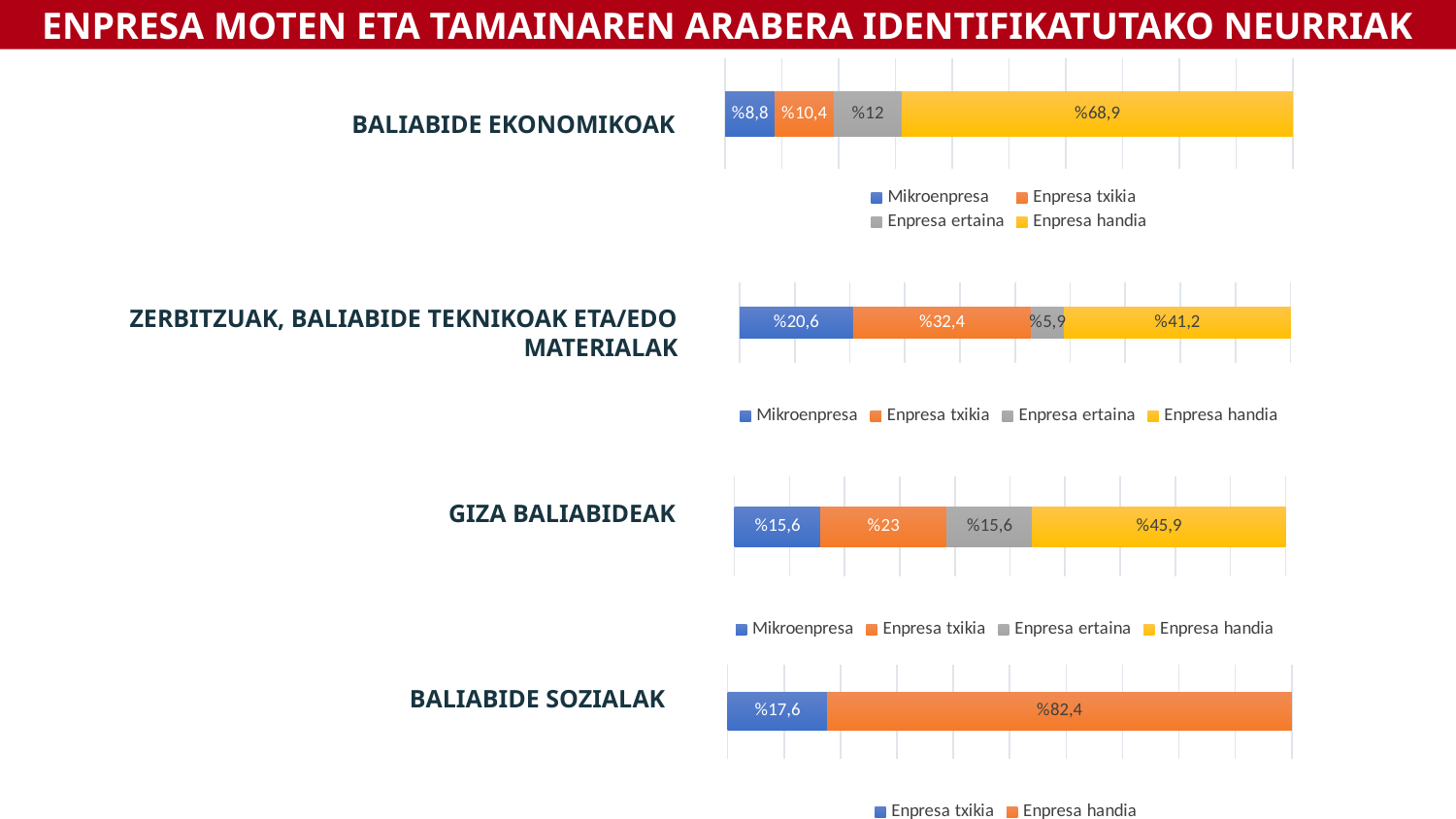
What kind of chart is the BALIABIDE EKONOMIKOAK chart? Stacked bar chart In the BALIABIDE EKONOMIKOAK chart, which series has the lowest value? Mikroenpresa In the BALIABIDE SOZIALAK chart, how many series does the legend list? 2 In the BALIABIDE EKONOMIKOAK chart, what is the value for Mikroenpresa? %8,8 In the BALIABIDE SOZIALAK chart, what is the value for Enpresa handia? %82,4 In the GIZA BALIABIDEAK chart, what is the value for Enpresa txikia? %23 In the ZERBITZUAK, BALIABIDE TEKNIKOAK ETA/EDO MATERIALAK chart, which series has the highest value? Enpresa handia In the GIZA BALIABIDEAK chart, how many series does the legend list? 4 In the GIZA BALIABIDEAK chart, which is larger, Enpresa handia or Enpresa txikia? Enpresa handia In the ZERBITZUAK, BALIABIDE TEKNIKOAK ETA/EDO MATERIALAK chart, what is the difference between Enpresa handia and Enpresa ertaina? %35,3 In the ZERBITZUAK, BALIABIDE TEKNIKOAK ETA/EDO MATERIALAK chart, what is the value for Enpresa txikia? %32,4 In the BALIABIDE EKONOMIKOAK chart, what is the value for Enpresa handia? %68,9